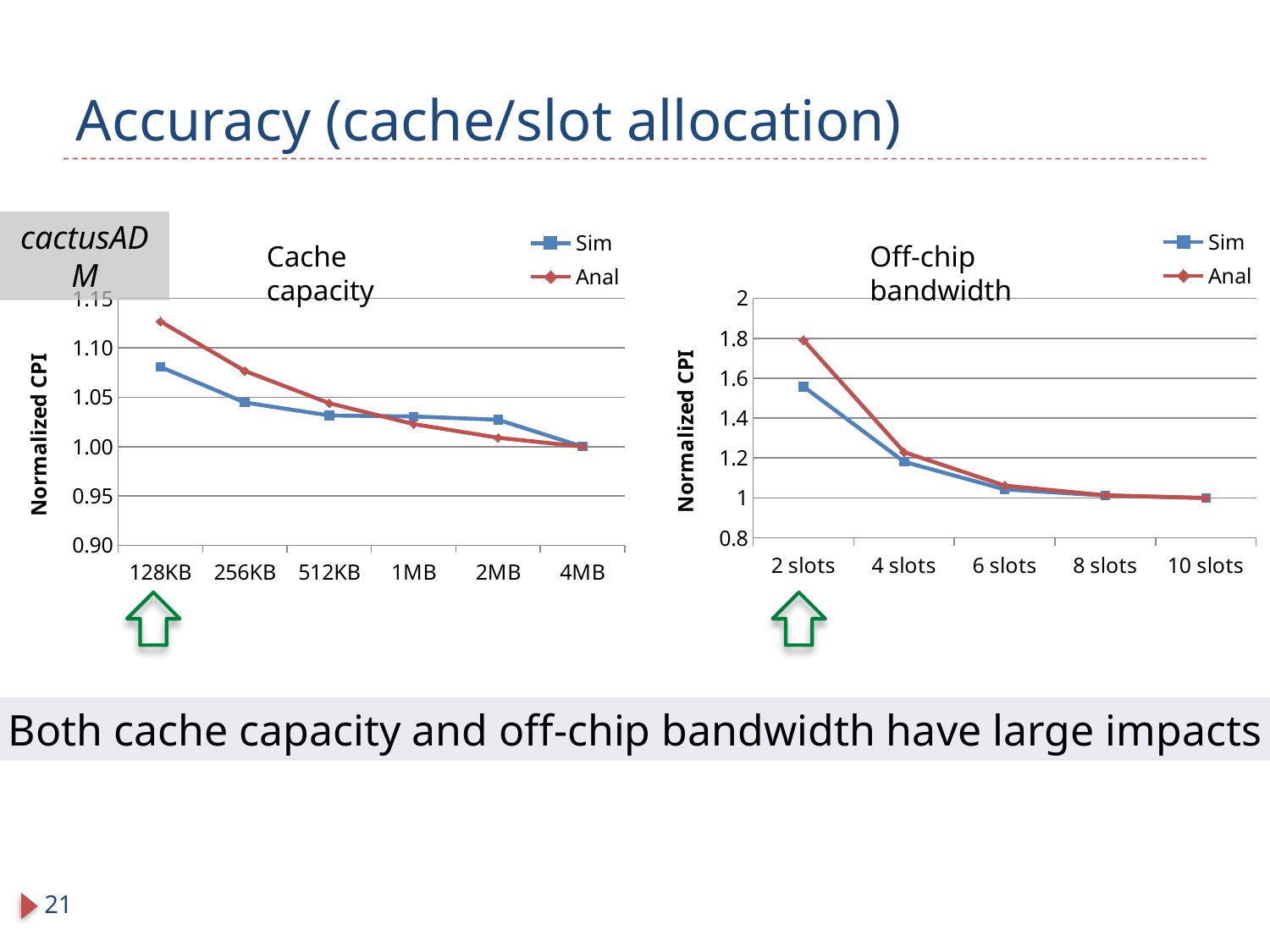
In the Cache capacity chart, do the Normalized CPI values rise or fall as cache capacity increases from 128KB to 4MB? fall How many slot counts are shown on the x axis of the Off-chip bandwidth chart? 5 In the Off-chip bandwidth chart, do the Normalized CPI values rise or fall as the number of slots increases? fall What kind of chart is the Cache capacity chart on the left? line chart In the Cache capacity chart, is the Sim value at 128KB greater or less than 1.10? less In the Off-chip bandwidth chart, which series has the larger value at 2 slots, Sim or Anal? Anal How many series does the legend of the Off-chip bandwidth chart list? 2 In the Cache capacity chart, is the Anal value at 128KB greater or less than 1.10? greater How many cache sizes are shown on the x axis of the Cache capacity chart? 6 What are the two series named in the legend of the Cache capacity chart? Sim and Anal In the Off-chip bandwidth chart, is the Sim value at 2 slots greater or less than 1.4? greater In the Cache capacity chart, at which cache size is the Anal series highest? 128KB